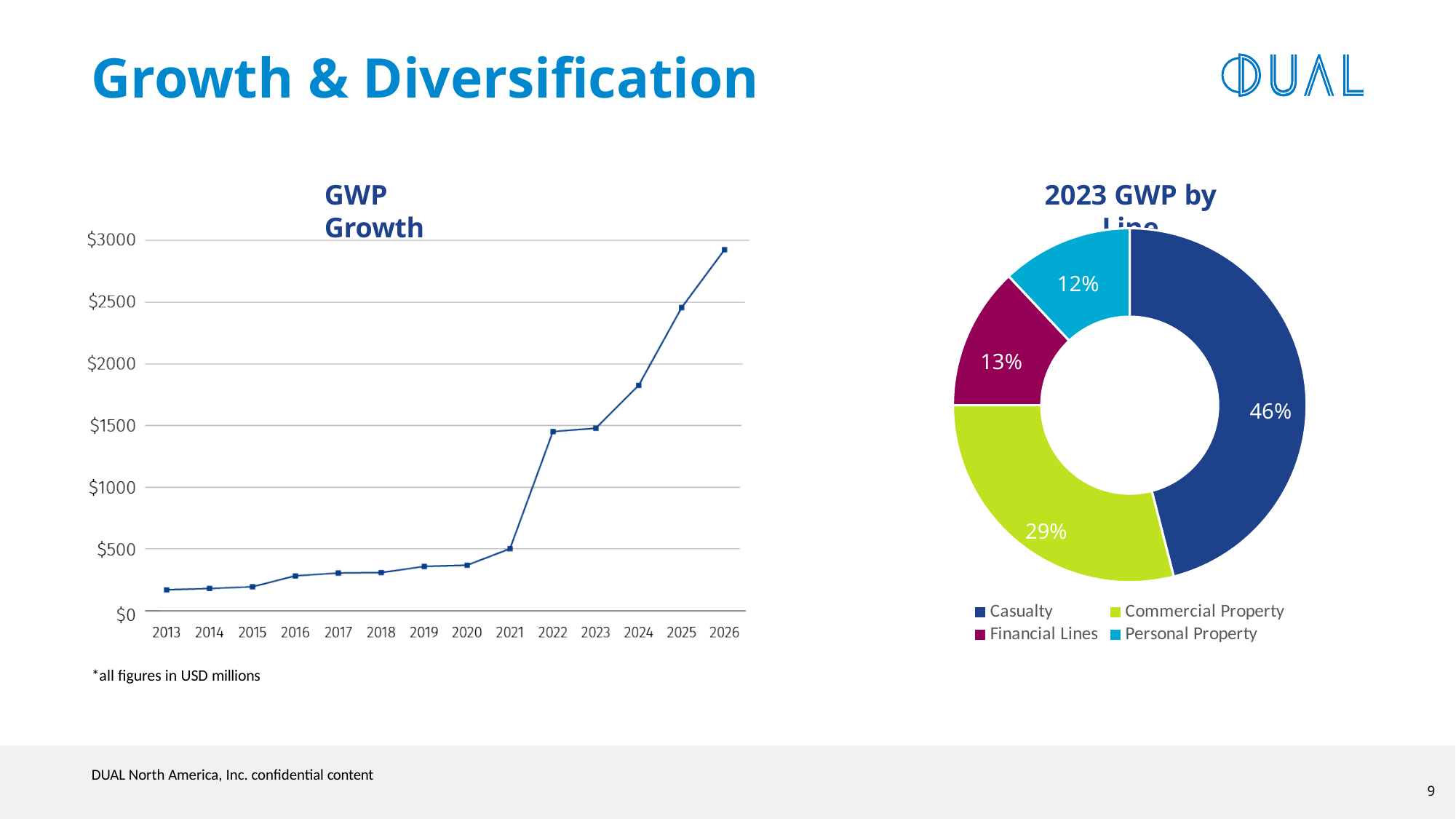
In the GWP Growth chart, is the value for 2013 greater or less than $500? less In the GWP Growth chart, how many years are shown on the x axis? 14 In the 2023 GWP by Line chart, what is the difference between the Commercial Property share and the Financial Lines share? 16% In the 2023 GWP by Line chart, what share does Casualty have? 46% In the GWP Growth chart, is the value for 2024 greater or less than $1500? greater In the GWP Growth chart, is the value for 2022 greater or less than $1000? greater In the 2023 GWP by Line chart, which line has the smallest share? Personal Property What type of chart is the 2023 GWP by Line chart? doughnut chart What type of chart is the GWP Growth chart? line chart In the GWP Growth chart, do the values generally rise or fall from 2013 to 2026? rise How many lines does the legend of the 2023 GWP by Line chart list? 4